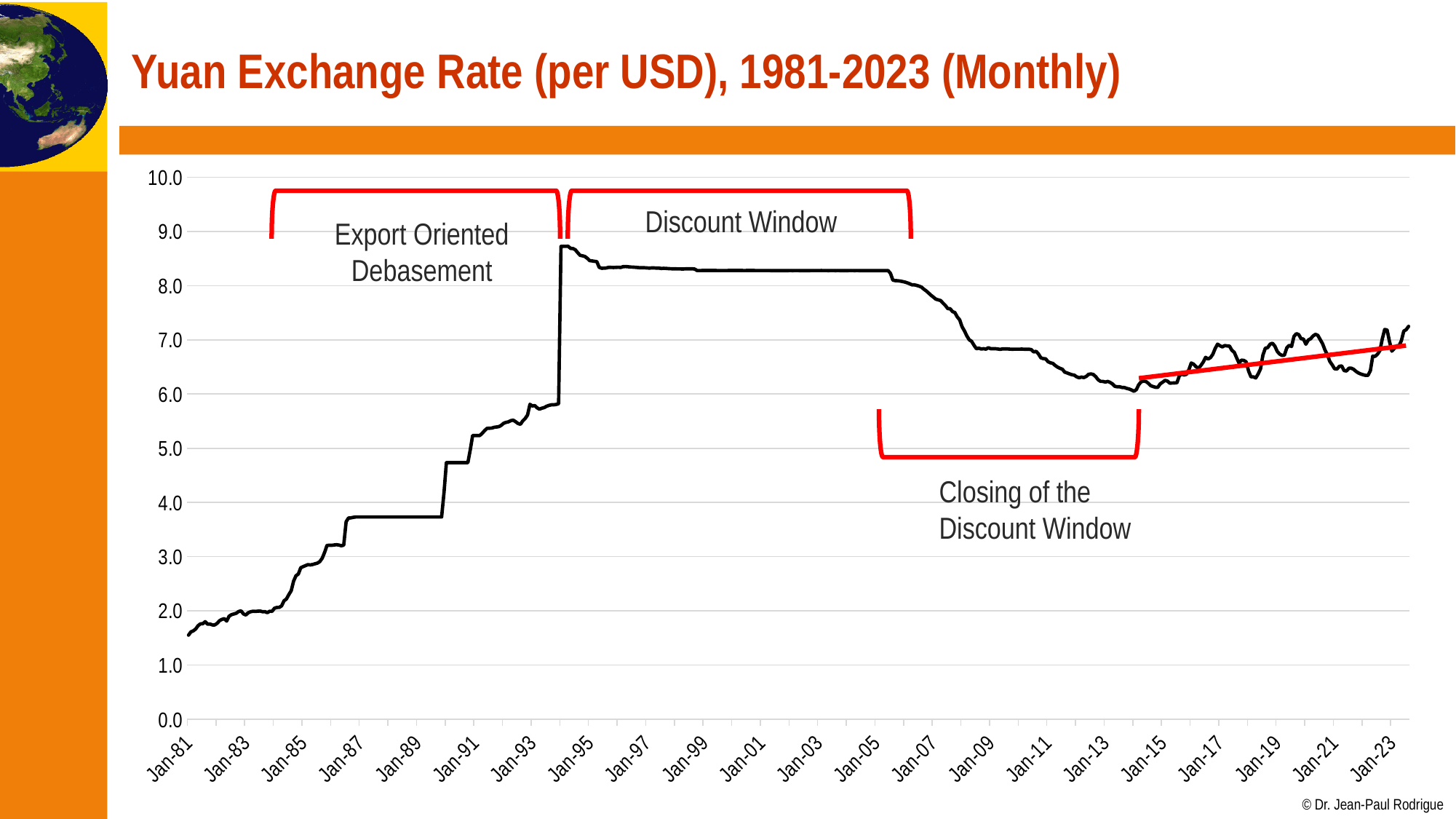
Is the exchange rate at Jan-21 greater or less than 7.0? less How many year labels are shown on the x axis? 22 Is the exchange rate at Jan-87 greater or less than 3.0? greater Is the highest value reached by the line greater or less than 8.0? greater Is the exchange rate at Jan-99 greater or less than 8.0? greater Does the exchange rate rise or fall between Jan-05 and Jan-13? falls What label is given to the period marked by the red bracket below the line, around 2005 to 2014? Closing of the Discount Window Does the exchange rate rise or fall between Jan-81 and Jan-93? rises What is the title of the chart? Yuan Exchange Rate (per USD), 1981-2023 (Monthly) What kind of chart is shown on the slide? line chart